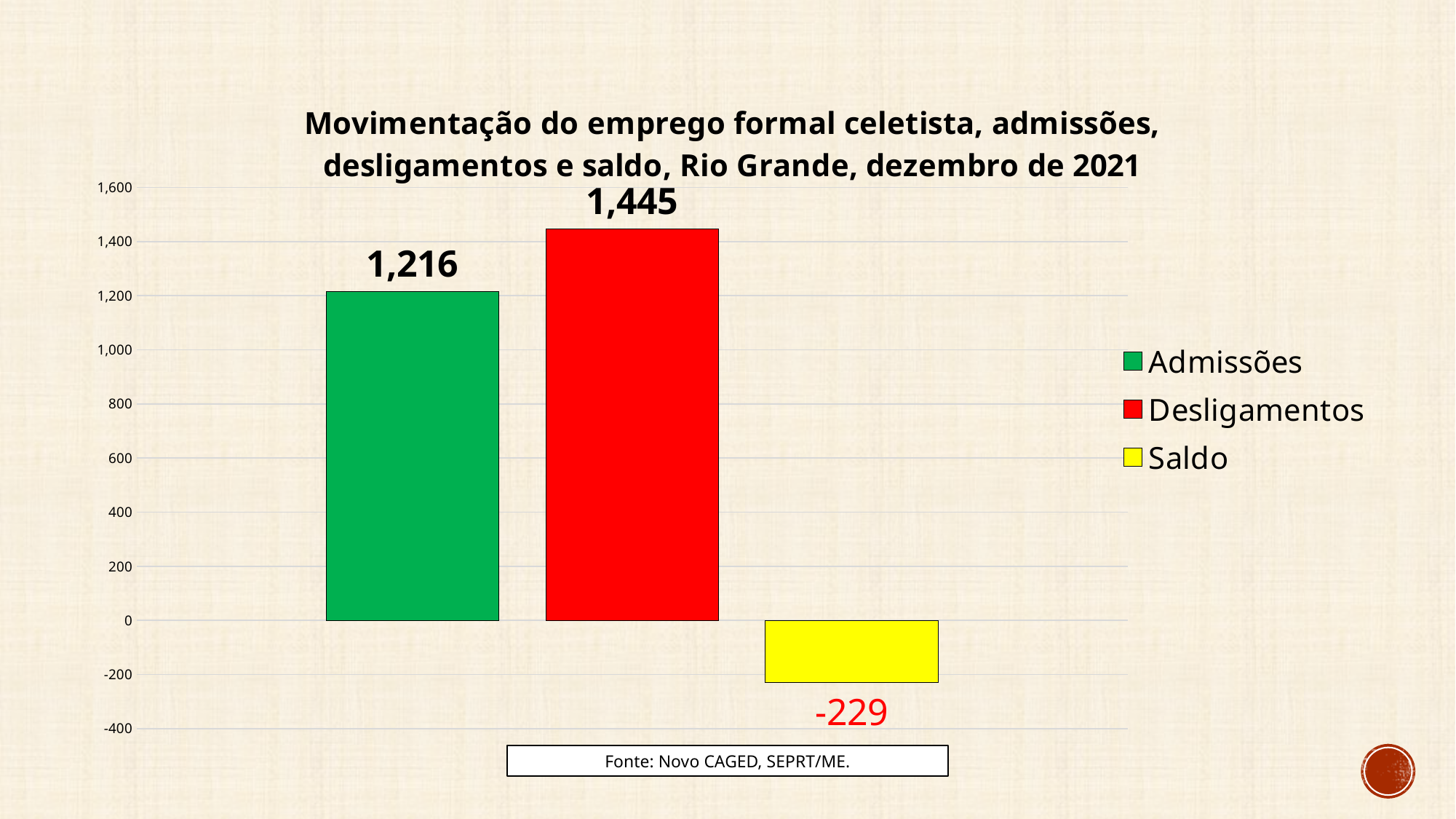
How many bars are plotted in the chart? 3 What is the value for Desligamentos? 1,445 How many series does the legend list? 3 Which series has the lowest value? Saldo What kind of chart is shown on the slide? bar chart What is the value for Saldo? -229 Is the value for Admissões greater or less than 1,200? greater What colour is the bar for Saldo? yellow Which is larger, Admissões or Desligamentos? Desligamentos What is the difference between Desligamentos and Admissões? 229 What is the value for Admissões? 1,216 Which series has the highest value? Desligamentos